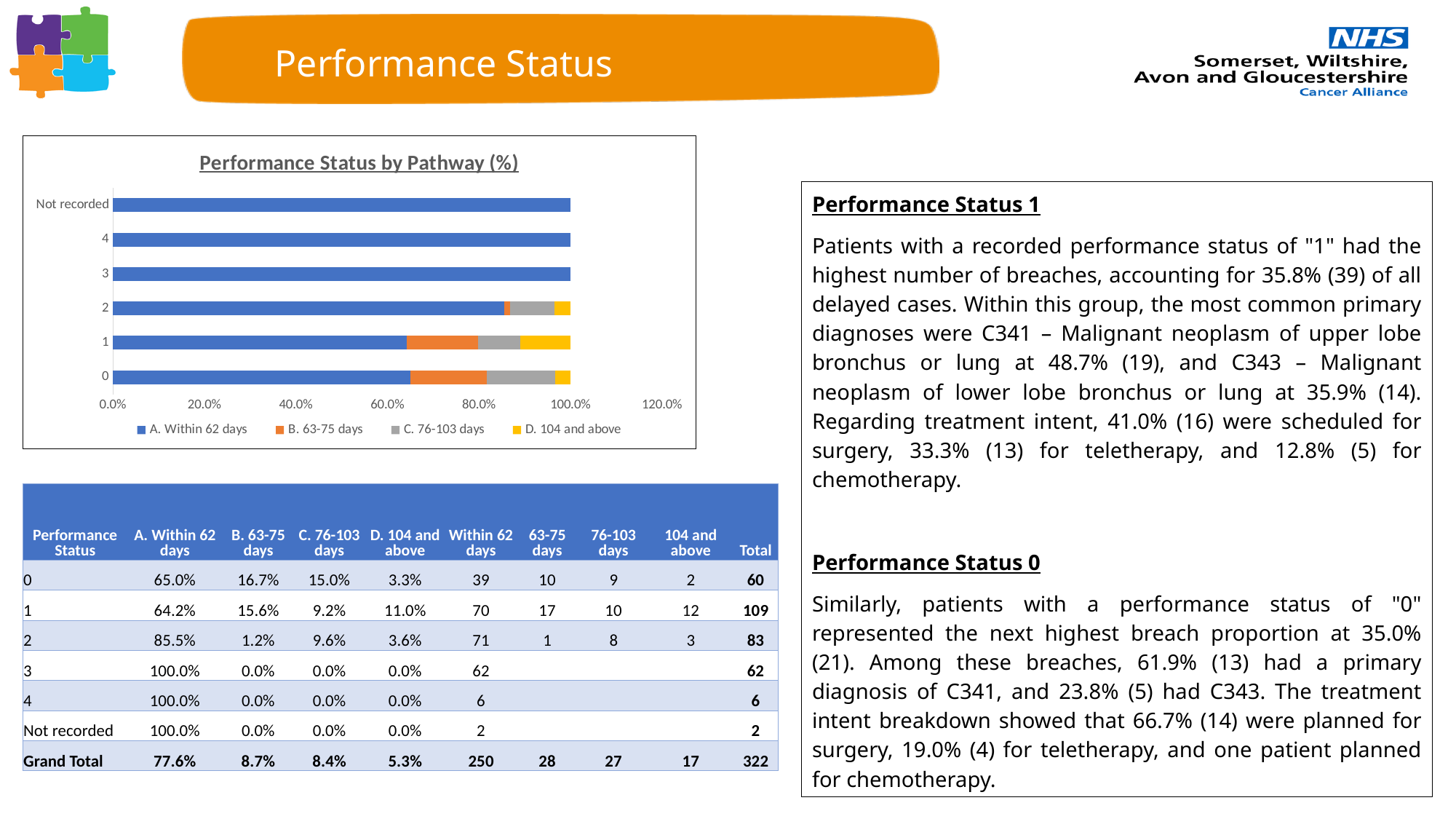
How many performance status categories are plotted on the y axis of the 'Performance Status by Pathway (%)' chart? 6 In the 'Performance Status by Pathway (%)' chart, which performance status has the largest 'D. 104 and above' segment? 1 In the 'Performance Status by Pathway (%)' chart, which has the larger 'A. Within 62 days' segment: performance status 2 or performance status 1? 2 In the 'Performance Status by Pathway (%)' chart, is the 'A. Within 62 days' value for performance status 0 greater or less than 60.0%? greater What colour represents 'D. 104 and above' in the 'Performance Status by Pathway (%)' chart? yellow Using the percentages in the table, what is the difference in 'A. Within 62 days' between performance status 2 and performance status 0? 20.5 percentage points In the 'Performance Status by Pathway (%)' chart, what is the value of 'A. Within 62 days' for 'Not recorded'? 100.0% In the 'Performance Status by Pathway (%)' chart, is the 'A. Within 62 days' value for performance status 2 greater or less than 80.0%? greater In the 'Performance Status by Pathway (%)' chart, what is the value of 'A. Within 62 days' for performance status 3? 100.0% What type of chart is 'Performance Status by Pathway (%)'? bar chart According to the table below the chart, what is the 'B. 63-75 days' percentage for performance status 0? 16.7% How many series does the legend of the 'Performance Status by Pathway (%)' chart list? 4